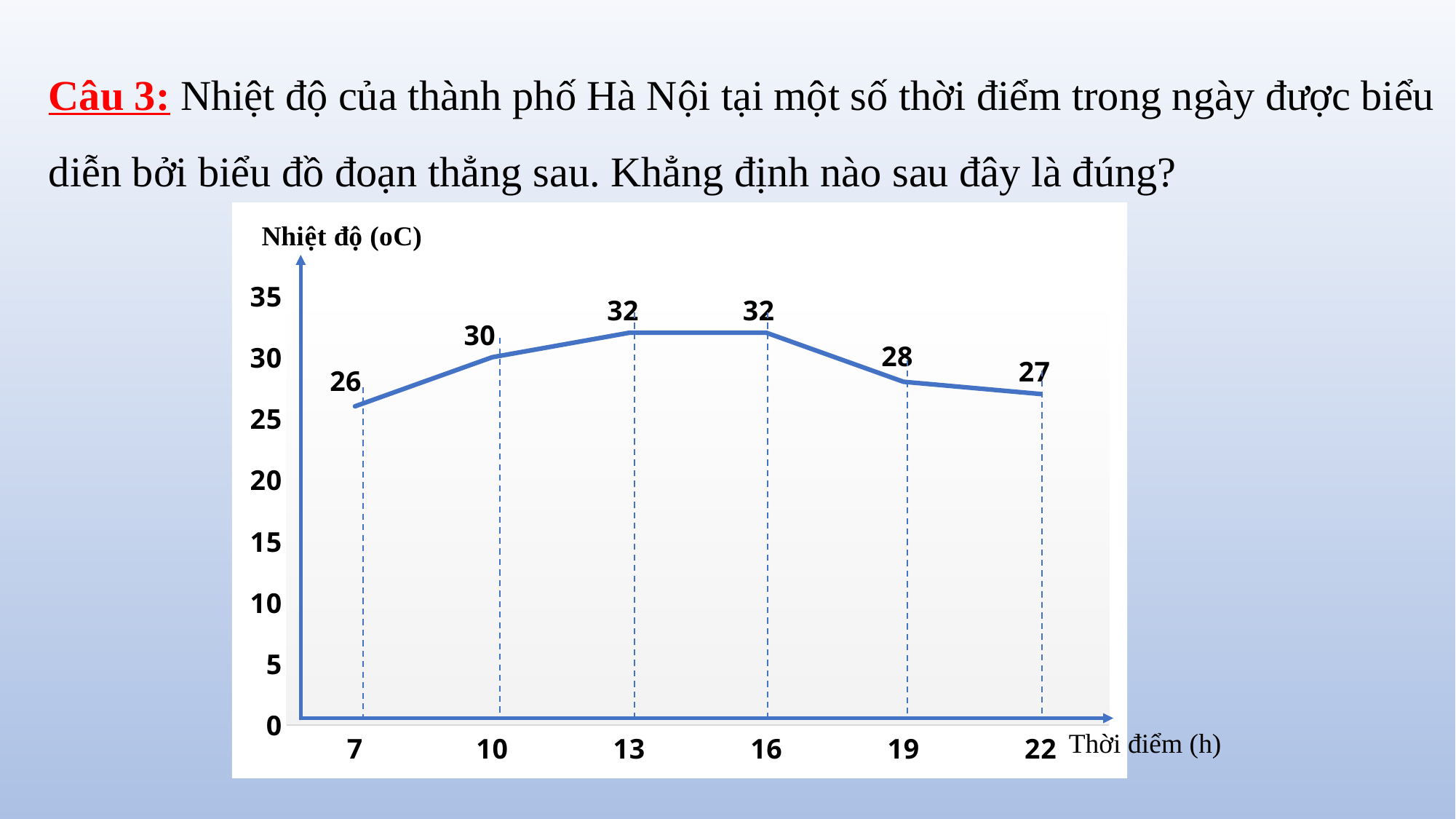
What is the difference between the temperature at 13h and the temperature at 7h? 6 What is the temperature at 10h? 30 What is the temperature at 7h? 26 What kind of chart is shown on the slide? line chart How many time points are plotted on the chart? 6 What is the temperature at 22h? 27 What is the highest temperature shown on the chart? 32 Which is higher, the temperature at 10h or the temperature at 19h? 10h Is the temperature at 22h greater or less than 30? less What is the temperature at 19h? 28 At which time is the temperature lowest? 7 Does the temperature rise or fall from 16h to 22h? fall